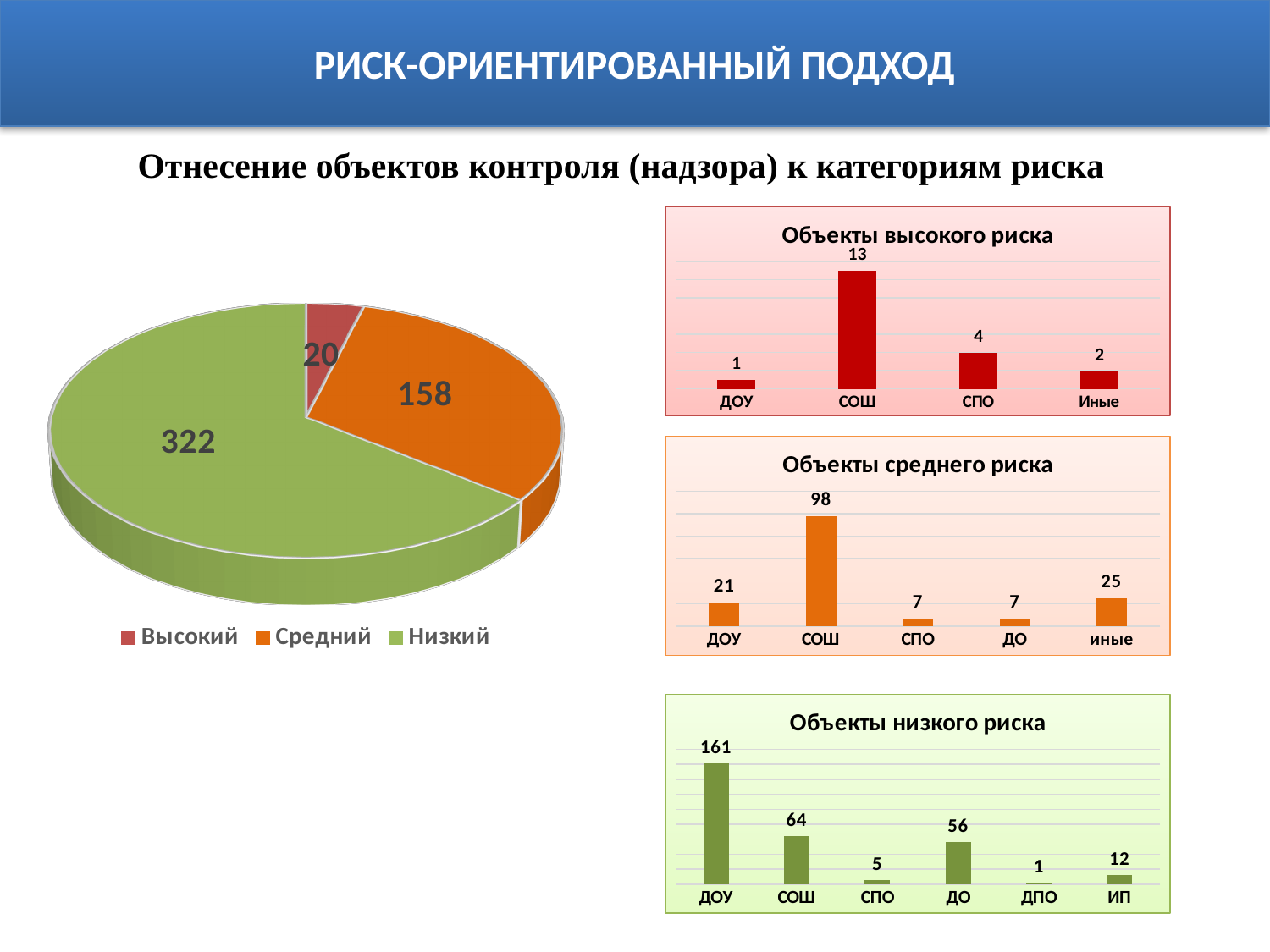
In the chart 'Объекты высокого риска', what is the value for СОШ? 13 In the chart 'Объекты низкого риска', what is the value for ДО? 56 In the chart 'Объекты низкого риска', which is larger, the value for ДОУ or the value for СОШ? ДОУ In the chart 'Объекты высокого риска', which category has the lowest value? ДОУ In the pie chart on the left, how many slices are there? 3 What kind of chart is 'Объекты низкого риска'? bar chart In the pie chart on the left, what is the difference between the values for Низкий and Средний? 164 In the pie chart on the left, what is the value for Высокий? 20 In the pie chart on the left, what is the value for Низкий? 322 In the chart 'Объекты среднего риска', how many categories are shown? 5 In the chart 'Объекты среднего риска', which category has the highest value? СОШ In the chart 'Объекты среднего риска', what is the value for иные? 25